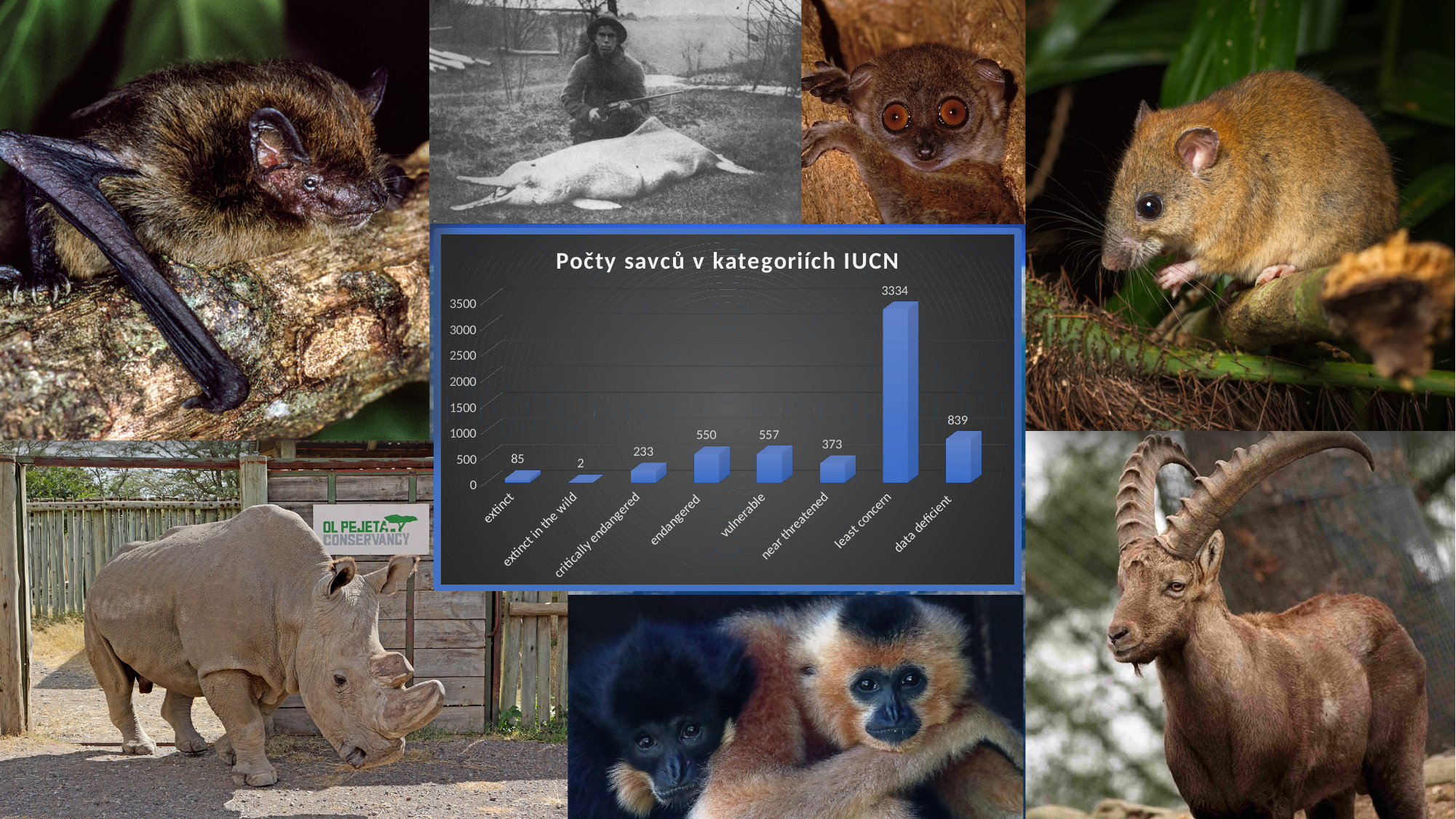
What is the difference between the values for 'vulnerable' and 'endangered'? 7 What kind of chart is shown on the slide? bar chart What is the difference between the values for 'data deficient' and 'near threatened'? 466 What is the value for the 'extinct in the wild' category? 2 What is the value for the 'near threatened' category? 373 How many categories are shown on the x axis? 8 What is the value for the 'least concern' category? 3334 Which category has the highest value? least concern Which is larger, the value for 'critically endangered' or the value for 'extinct'? critically endangered What is the value for the 'data deficient' category? 839 What is the title of the chart? Počty savců v kategoriích IUCN Which category has the lowest value? extinct in the wild